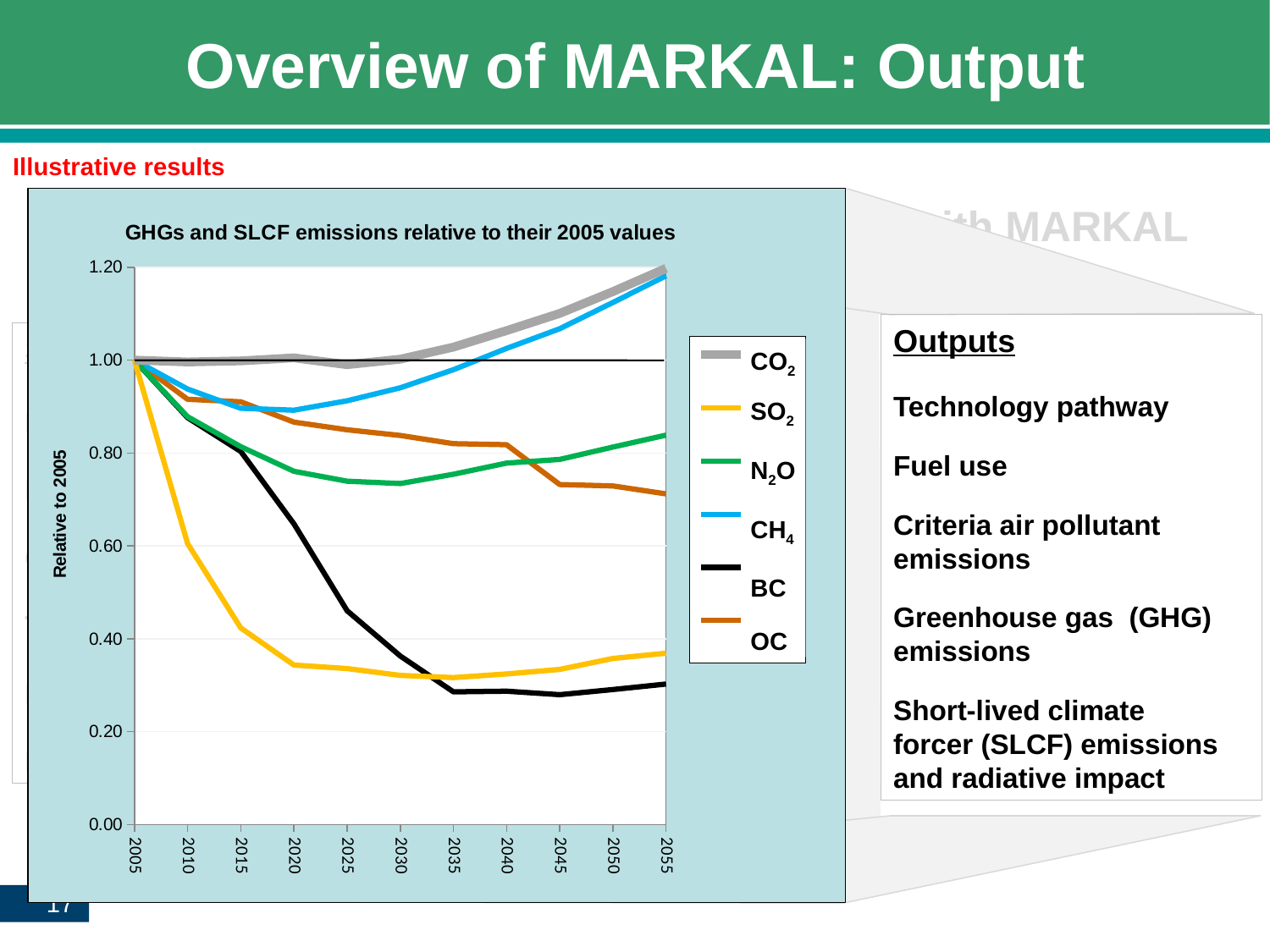
What kind of chart is shown on the slide? line chart Which series has the lowest value in 2055? BC How many years are marked along the x axis? 11 Is the value for CO2 in 2055 greater or less than 1.00? greater What is the label on the y axis? Relative to 2005 What is the value for CO2 in 2005? 1.00 How many series does the legend list? 6 Which series has the lowest value in 2020? SO2 What is the title of the chart? GHGs and SLCF emissions relative to their 2005 values Is the value for OC in 2055 greater or less than 0.80? less Is the value for SO2 in 2055 greater or less than 0.40? less In 2010, which is larger, the value for SO2 or the value for BC? BC